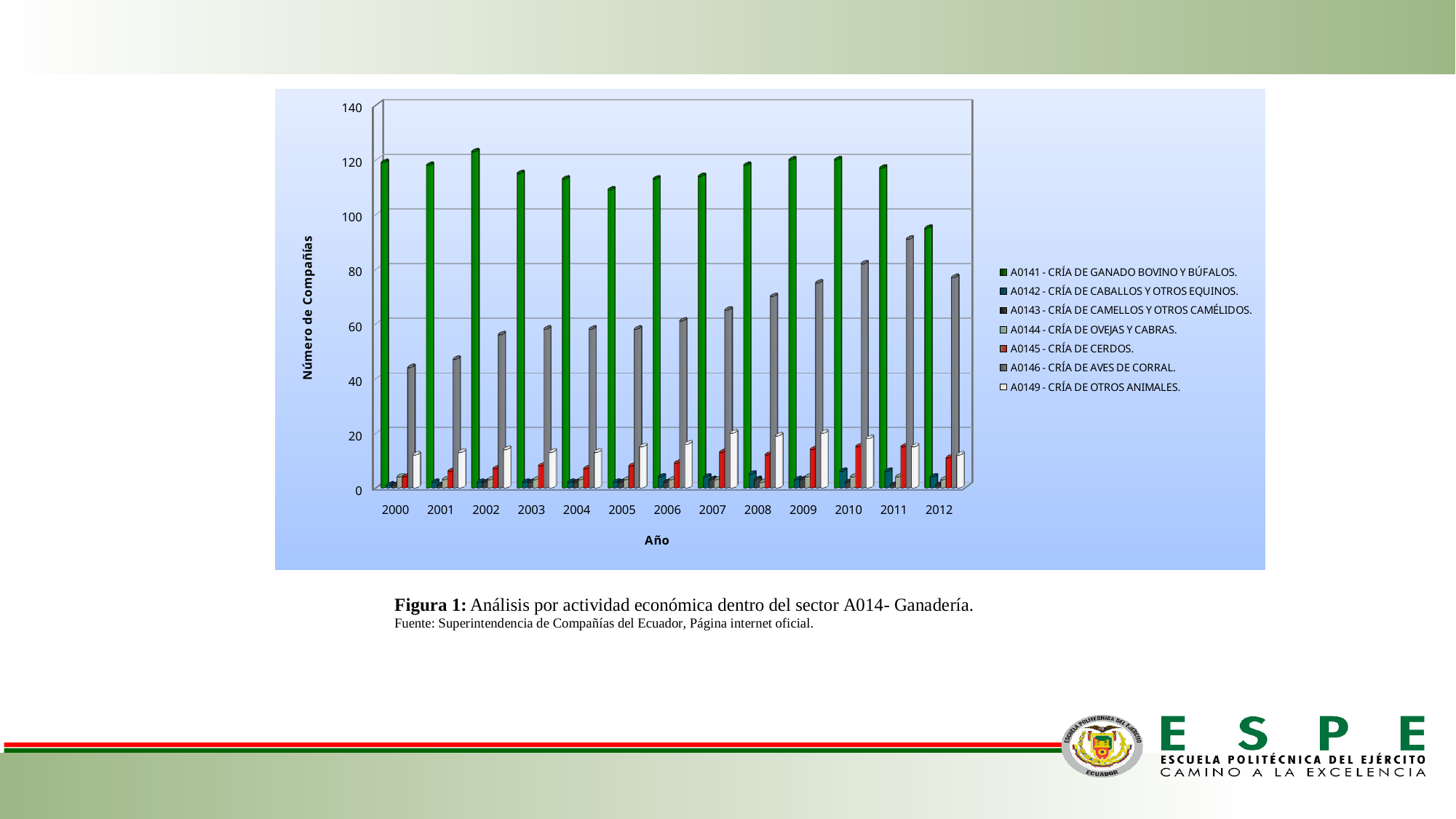
In 2005, which is larger: A0141 - CRÍA DE GANADO BOVINO Y BÚFALOS or A0146 - CRÍA DE AVES DE CORRAL? A0141 - CRÍA DE GANADO BOVINO Y BÚFALOS How many series does the chart's legend list? 7 In which year is the value for A0146 - CRÍA DE AVES DE CORRAL highest? 2011 Is the value for A0141 - CRÍA DE GANADO BOVINO Y BÚFALOS in 2000 greater or less than 100? greater What is the label of the chart's vertical axis? Número de Compañías Is the value for A0141 - CRÍA DE GANADO BOVINO Y BÚFALOS in 2012 greater or less than 100? less What kind of chart is shown on the slide? bar chart Does the value for A0146 - CRÍA DE AVES DE CORRAL generally rise or fall from 2000 to 2011? rise How many years are shown along the x axis of the chart? 13 Is the value for A0146 - CRÍA DE AVES DE CORRAL in 2011 greater or less than 80? greater In which year is the value for A0141 - CRÍA DE GANADO BOVINO Y BÚFALOS lowest? 2012